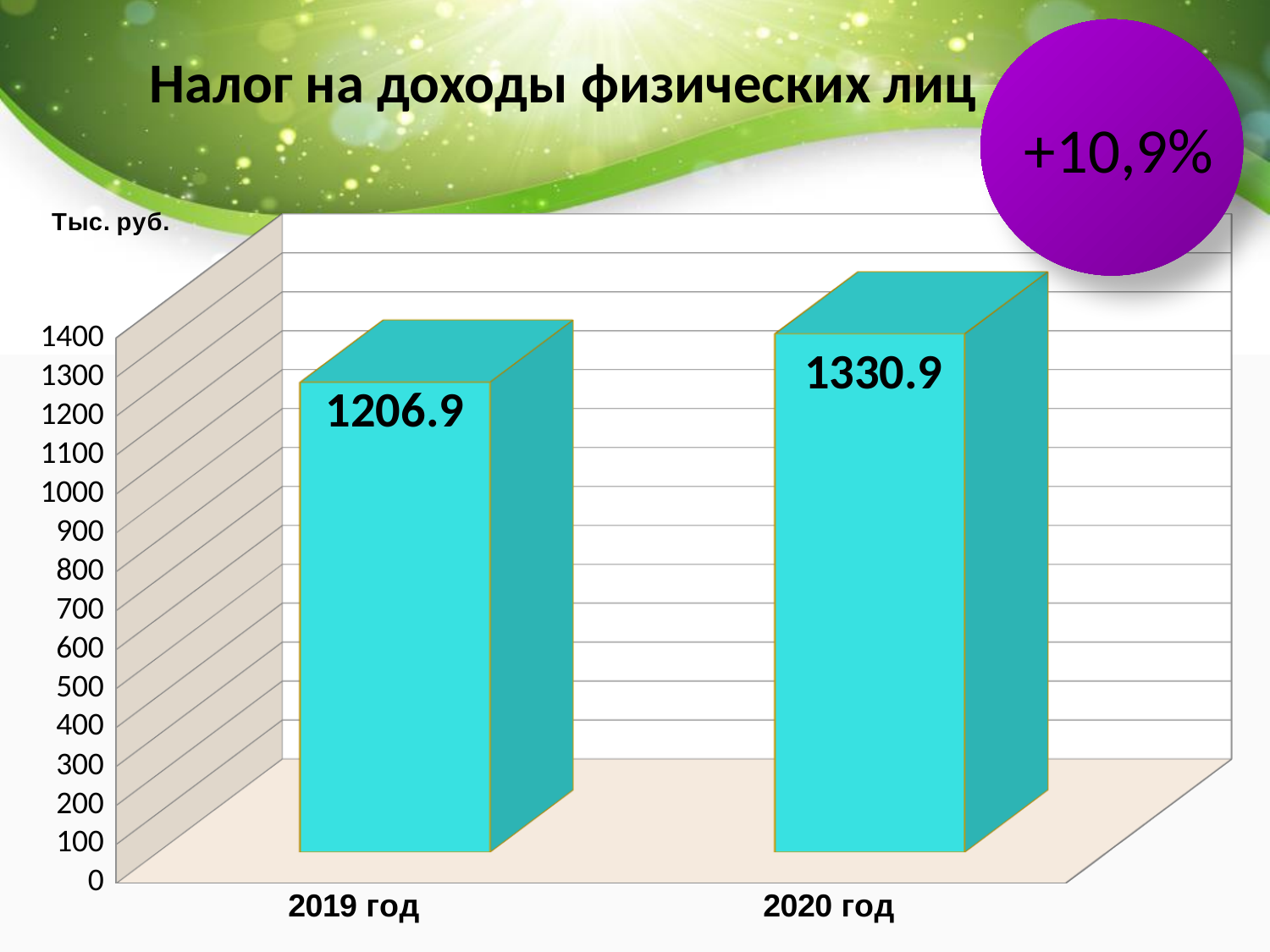
What is the title of the chart? Налог на доходы физических лиц Is the value for 2019 год larger or smaller than the value for 2020 год? smaller What is the value for 2020 год? 1330.9 Is the value for 2020 год greater or less than 1300? greater Do the values rise or fall from 2019 год to 2020 год? rise Which year has the lower value? 2019 год What kind of chart is shown on the slide? bar chart Is the value for 2019 год greater or less than 1300? less How many categories are shown on the chart? 2 What is the value for 2019 год? 1206.9 What is the difference between the values for 2020 год and 2019 год? 124.0 Which year has the higher value? 2020 год